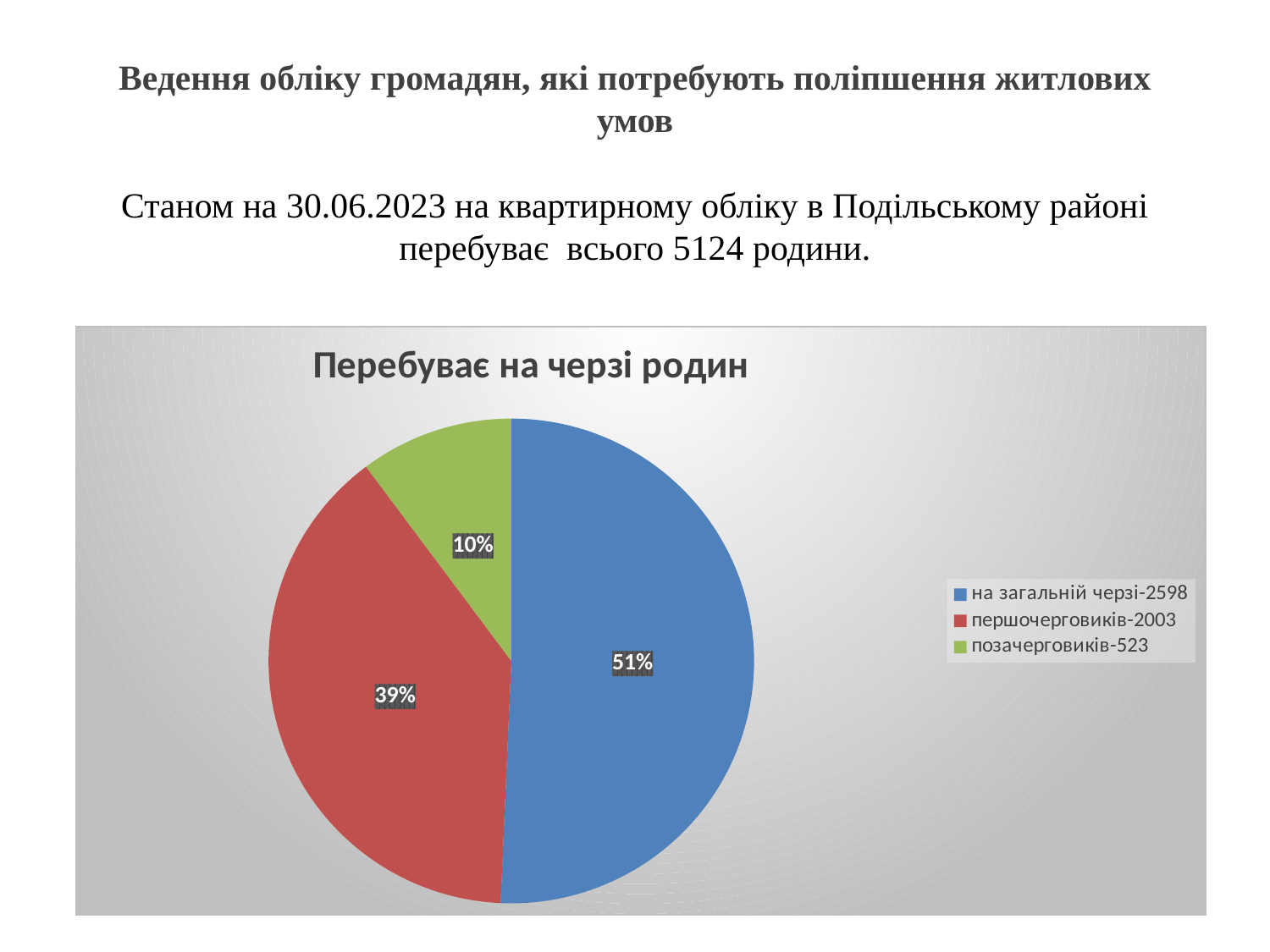
What share of the pie does the slice 'першочерговиків-2003' represent? 39% What is the title of the chart? Перебуває на черзі родин What share of the pie does the slice 'на загальній черзі-2598' represent? 51% What share of the pie does the slice 'позачерговиків-523' represent? 10% Which slice is the largest in the pie chart? на загальній черзі-2598 Which slice is the smallest in the pie chart? позачерговиків-523 What kind of chart is shown on the slide? pie chart What is the difference in percentage points between the 'на загальній черзі-2598' slice and the 'першочерговиків-2003' slice? 12% Which slice is larger: 'першочерговиків-2003' or 'позачерговиків-523'? першочерговиків-2003 What is the difference in percentage points between the 'першочерговиків-2003' slice and the 'позачерговиків-523' slice? 29% How many slices does the pie chart have? 3 What colour is the slice for 'позачерговиків-523'? green